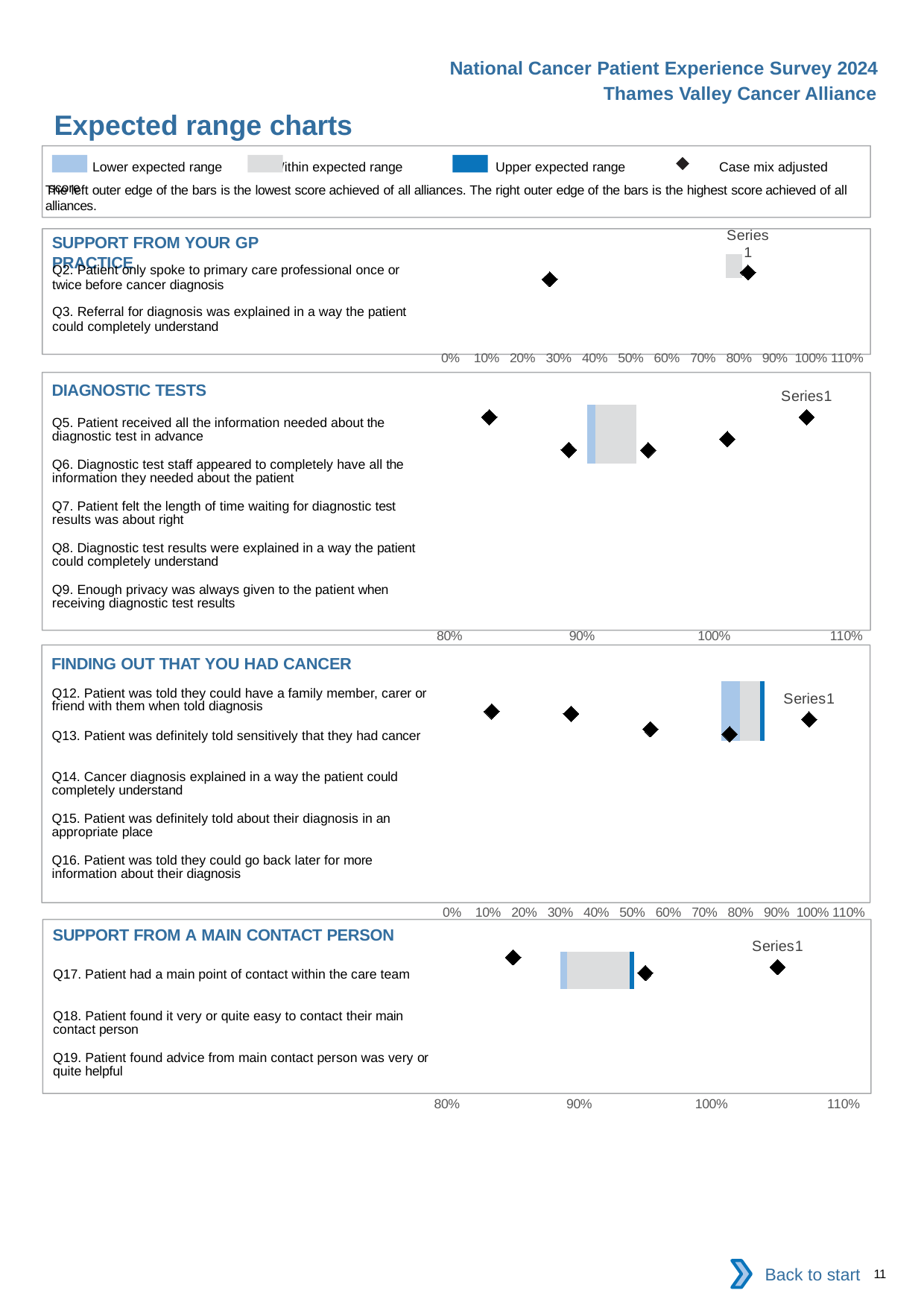
How many question items are listed in the DIAGNOSTIC TESTS chart? 5 In the DIAGNOSTIC TESTS chart, is the leftmost diamond marker greater or less than 90%? less How many series does the legend of the DIAGNOSTIC TESTS chart list? 1 How many question items are listed in the SUPPORT FROM YOUR GP PRACTICE chart? 2 What is the lowest axis tick shown on the DIAGNOSTIC TESTS chart? 80% How many question items are listed in the SUPPORT FROM A MAIN CONTACT PERSON chart? 3 In the FINDING OUT THAT YOU HAD CANCER chart, is the leftmost diamond marker greater or less than 20%? less What is the highest axis tick shown on the FINDING OUT THAT YOU HAD CANCER chart? 110%